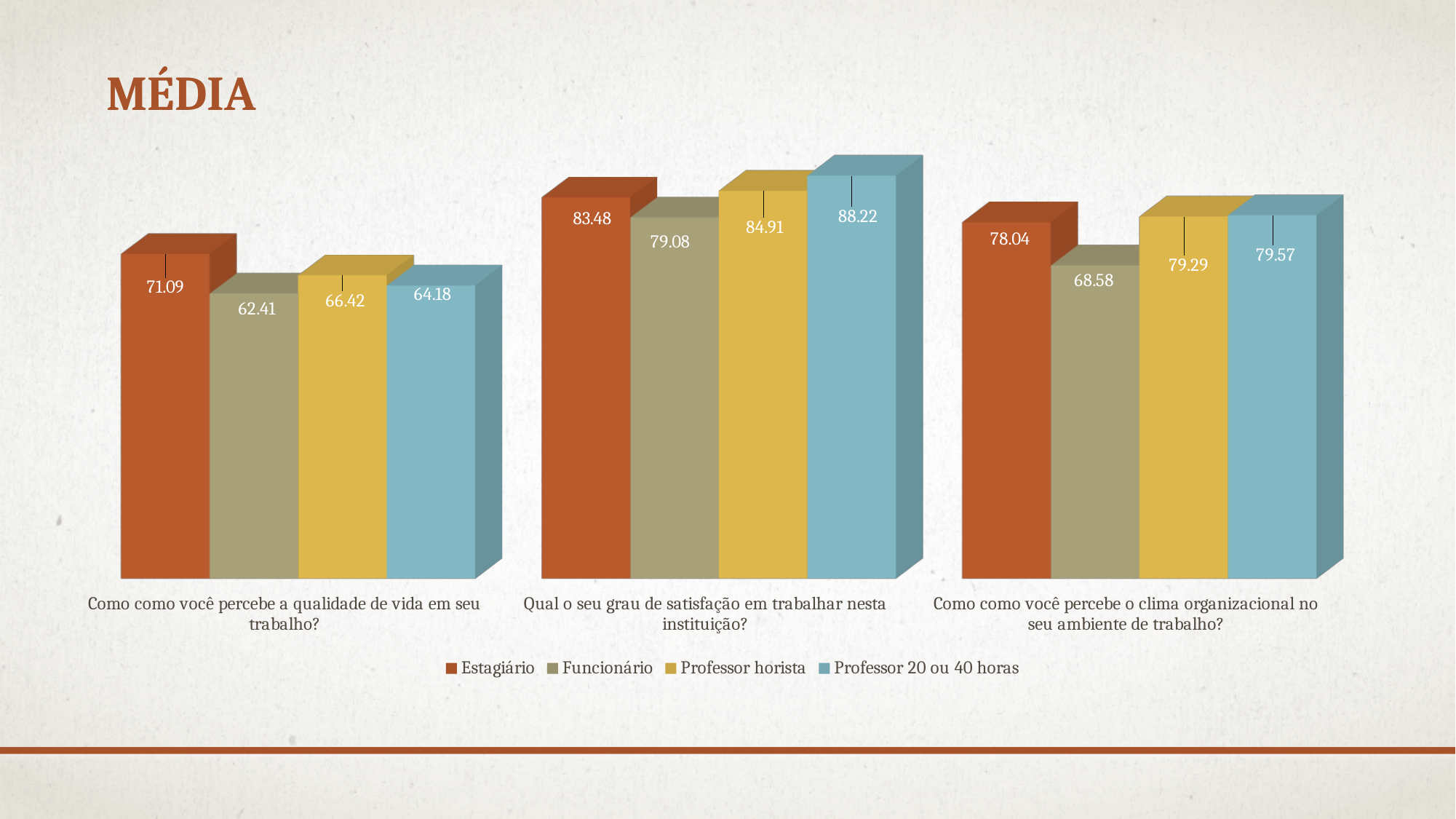
What is the difference between the Professor 20 ou 40 horas and Professor horista values in the category "Qual o seu grau de satisfação em trabalhar nesta instituição?"? 3.31 What kind of chart is shown on the slide? Bar chart What is the value for Professor 20 ou 40 horas in the category "Qual o seu grau de satisfação em trabalhar nesta instituição?"? 88.22 What is the value for Funcionário in the category "Como como você percebe o clima organizacional no seu ambiente de trabalho?"? 68.58 What is the title of the slide above the chart? MÉDIA How many categories are shown on the x axis of the chart? 3 What is the difference between the Estagiário and Funcionário values in the category "Como como você percebe a qualidade de vida em seu trabalho?"? 8.68 How many series does the legend list? 4 Which series has the lowest value in the category "Como como você percebe a qualidade de vida em seu trabalho?"? Funcionário Which series has the highest value in the category "Qual o seu grau de satisfação em trabalhar nesta instituição?"? Professor 20 ou 40 horas What is the value for Estagiário in the category "Como como você percebe a qualidade de vida em seu trabalho?"? 71.09 In the category "Como como você percebe o clima organizacional no seu ambiente de trabalho?", which is larger: the Estagiário value or the Funcionário value? Estagiário